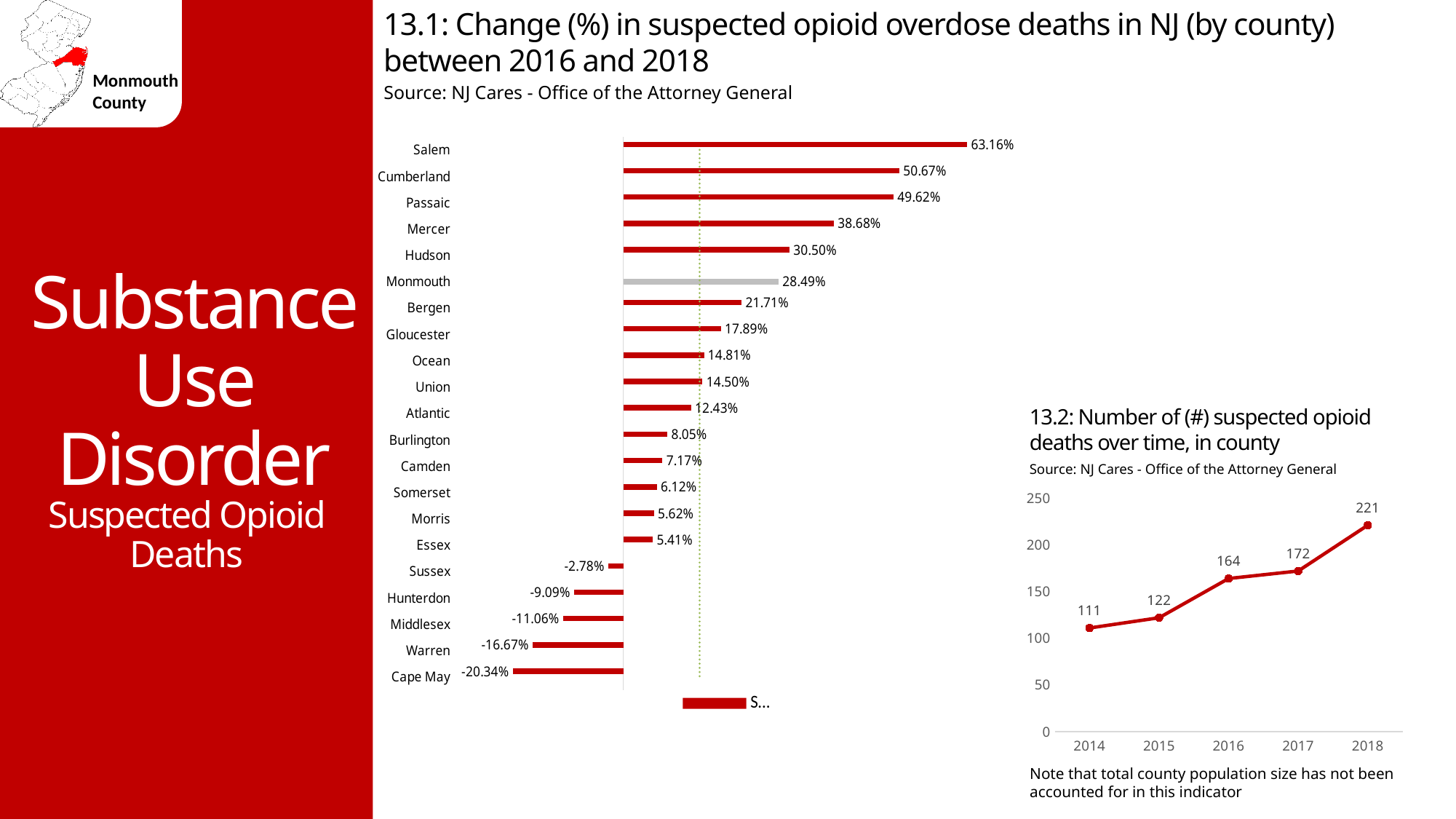
In chart 13.1 (Change (%) in suspected opioid overdose deaths in NJ by county), which county has the highest value? Salem In chart 13.1 (Change (%) in suspected opioid overdose deaths in NJ by county), which county has the lowest value? Cape May In chart 13.2 (Number of (#) suspected opioid deaths over time, in county), do the values rise or fall from 2014 to 2018? Rise In chart 13.1 (Change (%) in suspected opioid overdose deaths in NJ by county), what is the value for Hudson? 30.50% In chart 13.1 (Change (%) in suspected opioid overdose deaths in NJ by county), how many counties are shown? 21 In chart 13.2 (Number of (#) suspected opioid deaths over time, in county), what is the value for 2018? 221 In chart 13.1 (Change (%) in suspected opioid overdose deaths in NJ by county), what is the difference between the values for Salem and Cumberland? 12.49% In chart 13.2 (Number of (#) suspected opioid deaths over time, in county), what is the difference between the values for 2018 and 2014? 110 In chart 13.1 (Change (%) in suspected opioid overdose deaths in NJ by county), what is the value for Monmouth? 28.49% What kind of chart is chart 13.2 (Number of (#) suspected opioid deaths over time, in county)? Line chart In chart 13.1 (Change (%) in suspected opioid overdose deaths in NJ by county), which is larger, the value for Passaic or the value for Mercer? Passaic What kind of chart is chart 13.1 (Change (%) in suspected opioid overdose deaths in NJ by county)? Bar chart